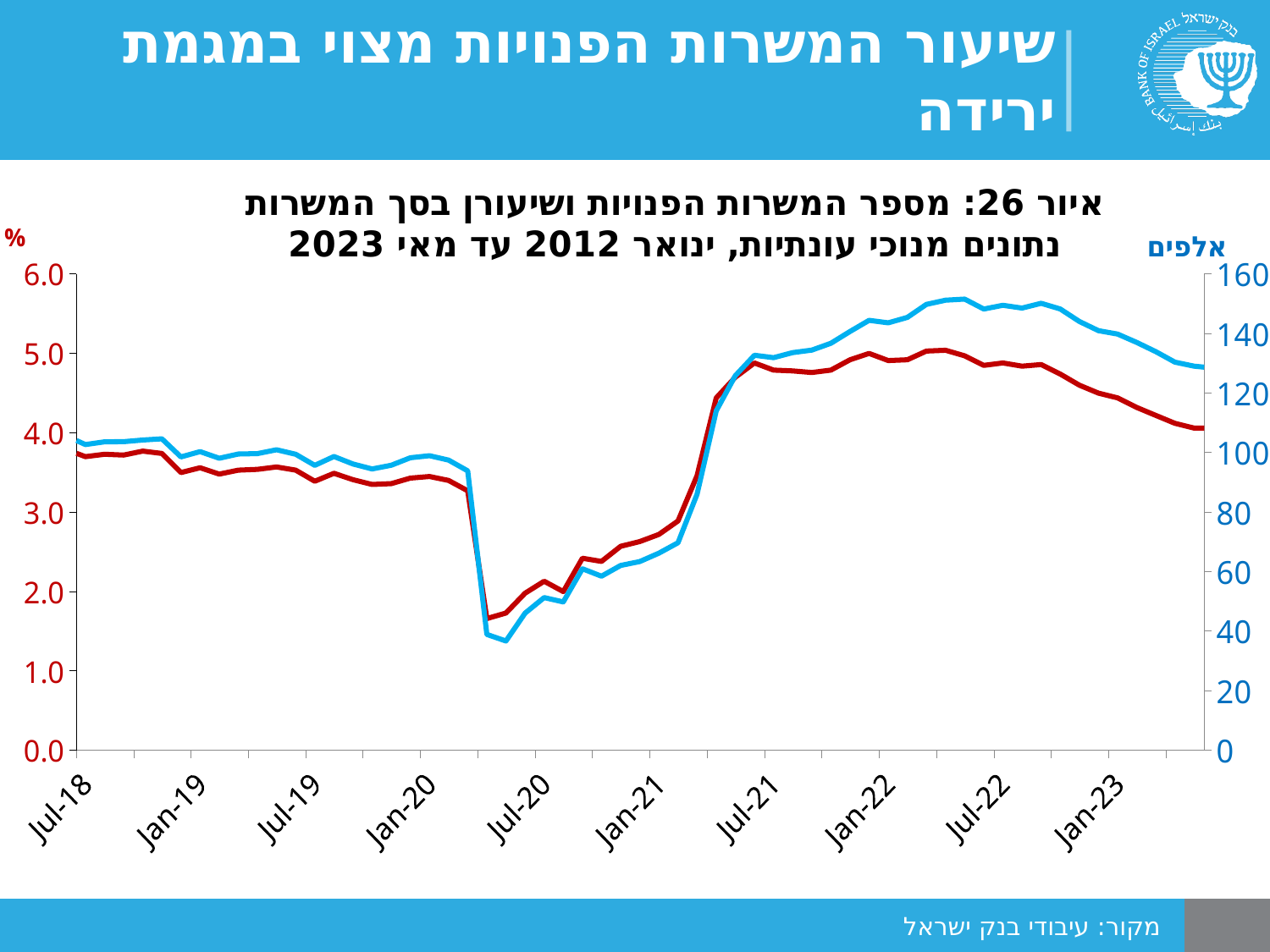
What is the unit label shown above the right vertical axis? אלפים Does the blue line rise or fall between Jul-20 and Jul-21? rise What kind of chart is shown on the slide? line chart Does the red line rise or fall between Jan-22 and the end of the series? fall Is the value of the blue line at Jul-20 greater or less than 80? less Is the value of the red line at Jul-18 greater or less than 3.0? greater What is the unit label shown above the left vertical axis? % Is the value of the red line at Jan-23 greater or less than 4.0? greater How many lines are plotted on the chart? 2